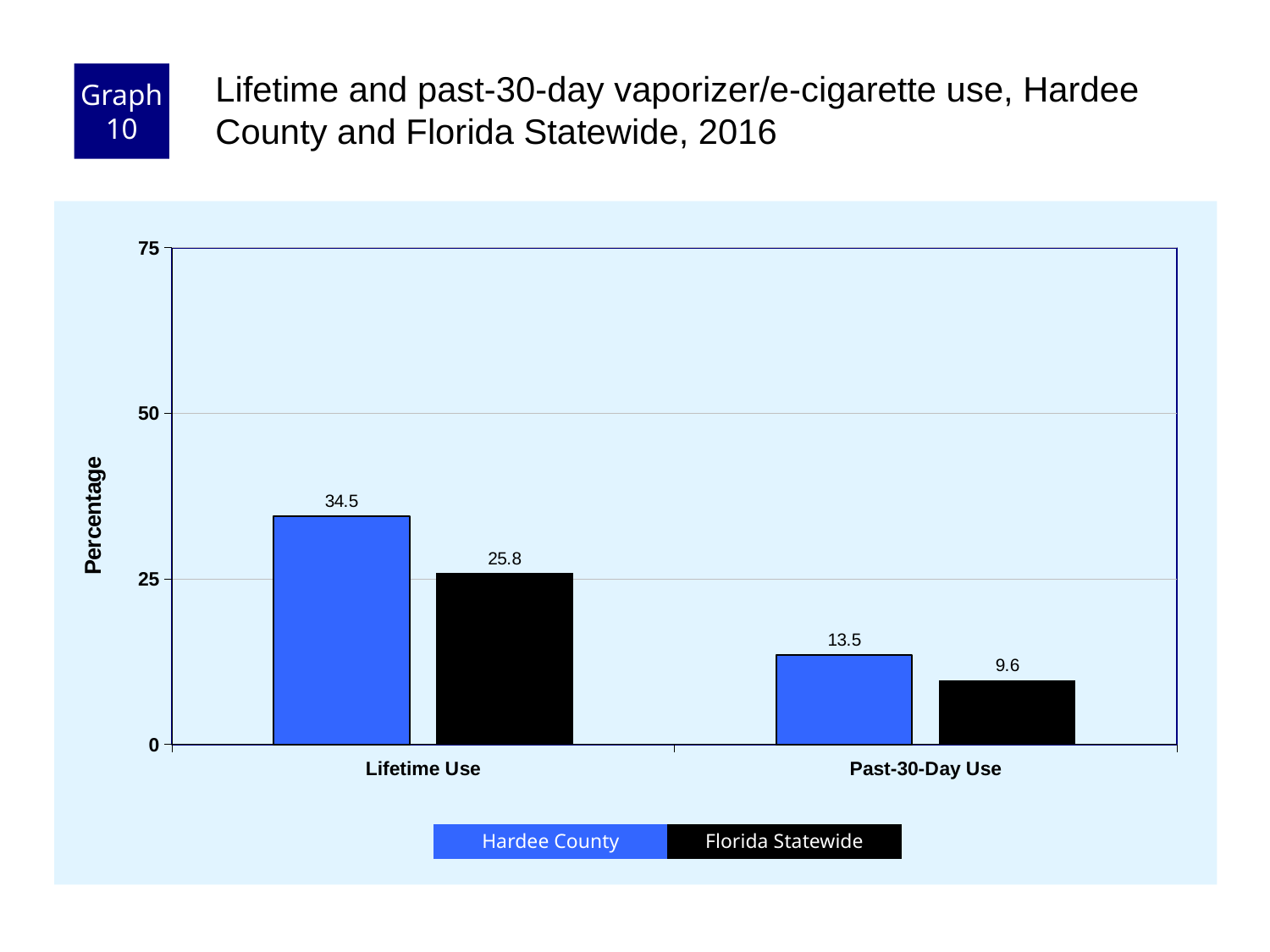
Which is larger for Past-30-Day Use: Hardee County or Florida Statewide? Hardee County How many series does the legend list? 2 Which bar has the highest value on the chart? Hardee County, Lifetime Use What is the Hardee County value for Past-30-Day Use? 13.5 What kind of chart is shown on the slide? Bar chart Which bar has the lowest value on the chart? Florida Statewide, Past-30-Day Use What is the difference between the Hardee County and Florida Statewide values for Lifetime Use? 8.7 What is the Florida Statewide value for Past-30-Day Use? 9.6 What is the Florida Statewide value for Lifetime Use? 25.8 What is the Hardee County value for Lifetime Use? 34.5 Is the Florida Statewide value for Lifetime Use greater or less than 25? greater What is the difference between the Hardee County and Florida Statewide values for Past-30-Day Use? 3.9